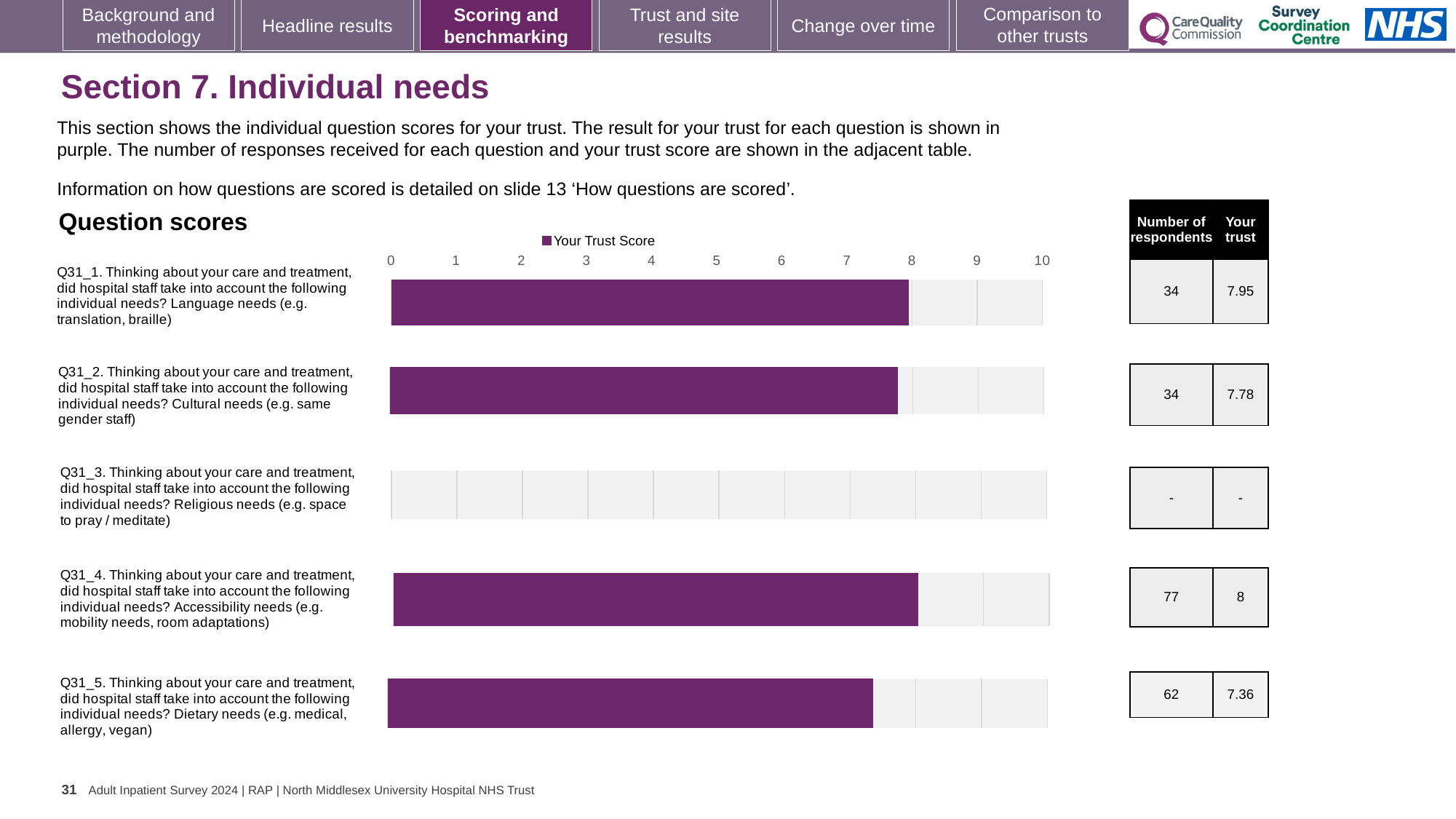
What is the trust score for Q31_5 (Dietary needs)? 7.36 Among the questions with a plotted bar, which has the lowest trust score? Q31_5 (Dietary needs) What is the difference between the trust scores for Q31_1 and Q31_2? 0.17 What is the difference between the trust scores for Q31_4 and Q31_5? 0.64 Which question has the highest trust score on the chart? Q31_4 (Accessibility needs) What is the trust score for Q31_1 (Language needs)? 7.95 How many respondents answered Q31_4 (Accessibility needs)? 77 Which has the larger trust score, Q31_1 (Language needs) or Q31_2 (Cultural needs)? Q31_1 (Language needs) How many questions are listed on the chart? 5 What kind of chart is shown on the slide? Bar chart How many series does the chart legend list? 1 Is the trust score for Q31_5 (Dietary needs) greater or less than 8? less